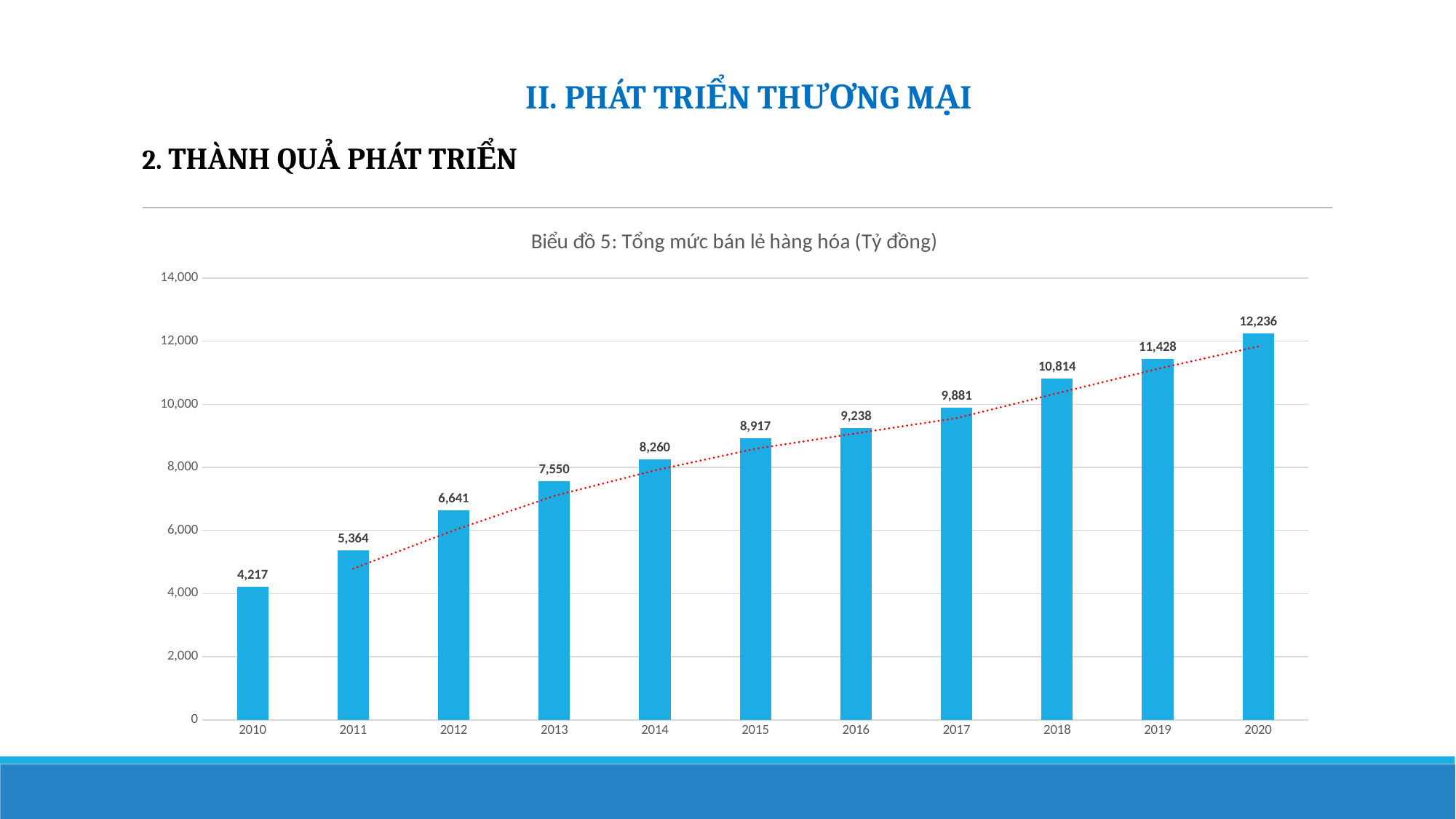
Which year has the lowest value? 2010 How many years are shown on the x axis? 11 What is the value for 2015? 8,917 What is the difference between the values for 2014 and 2013? 710 What is the value for 2018? 10,814 What is the value for 2010? 4,217 Which is larger, the value for 2016 or the value for 2017? 2017 What is the difference between the values for 2020 and 2019? 808 Which year has the highest value? 2020 What kind of chart is this? bar chart Do the values rise or fall from 2010 to 2020? rise Is the value for 2012 greater or less than 6,000? greater